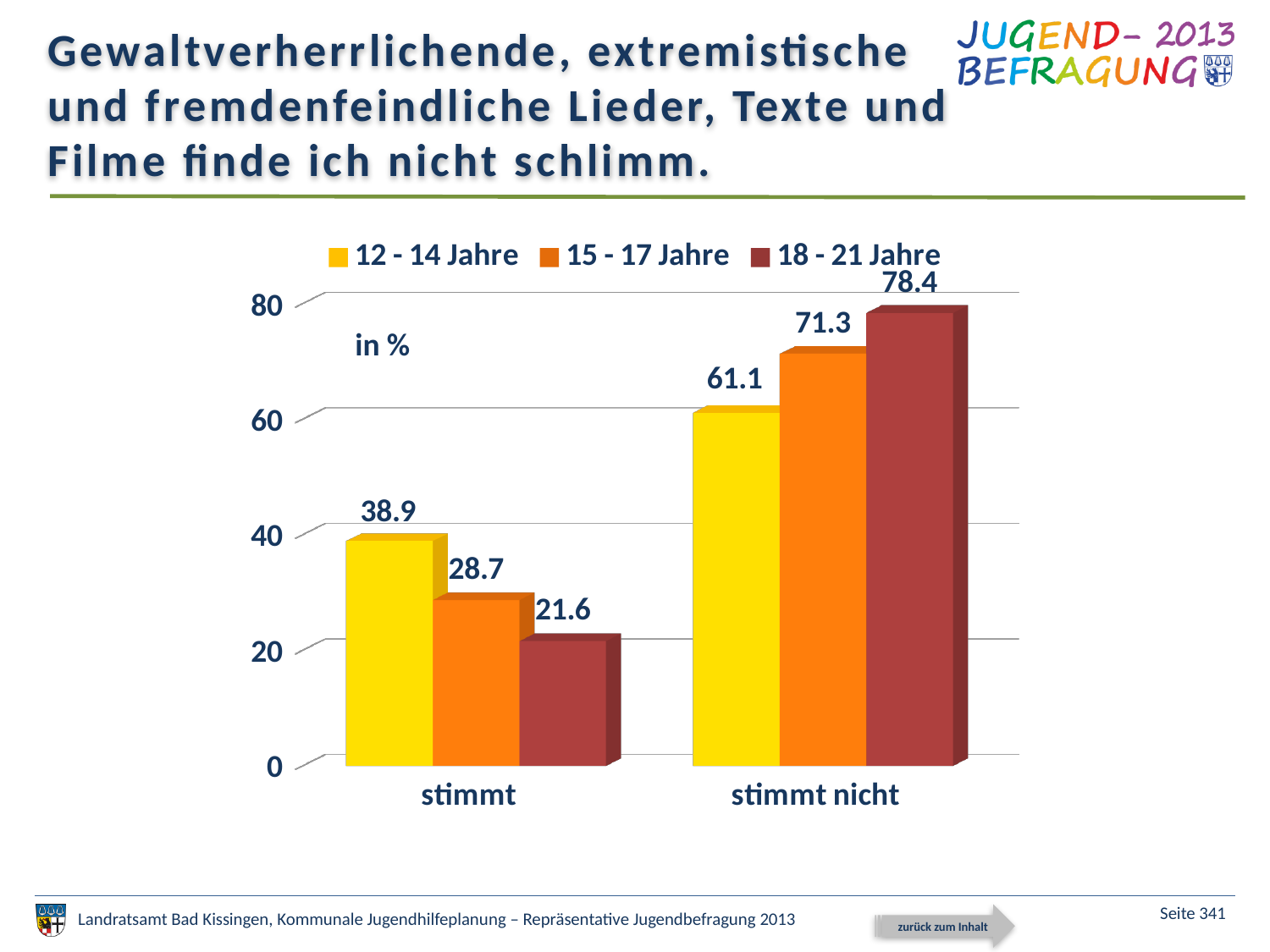
Which is larger: the 15 - 17 Jahre value for "stimmt" or the 12 - 14 Jahre value for "stimmt nicht"? 12 - 14 Jahre value for "stimmt nicht" What is the value for the 18 - 21 Jahre series in the "stimmt nicht" category? 78.4 How many categories are shown on the x axis? 2 Is the 12 - 14 Jahre value for "stimmt nicht" greater or less than 60? greater What kind of chart is shown on the slide? bar chart What is the difference between the 18 - 21 Jahre and 15 - 17 Jahre values in the "stimmt nicht" category? 7.1 Which age group has the highest value in the "stimmt nicht" category? 18 - 21 Jahre How many series does the legend list? 3 Which age group has the lowest value in the "stimmt" category? 18 - 21 Jahre What is the difference between the 12 - 14 Jahre and 18 - 21 Jahre values in the "stimmt" category? 17.3 What is the value for the 12 - 14 Jahre series in the "stimmt" category? 38.9 What is the value for the 15 - 17 Jahre series in the "stimmt" category? 28.7